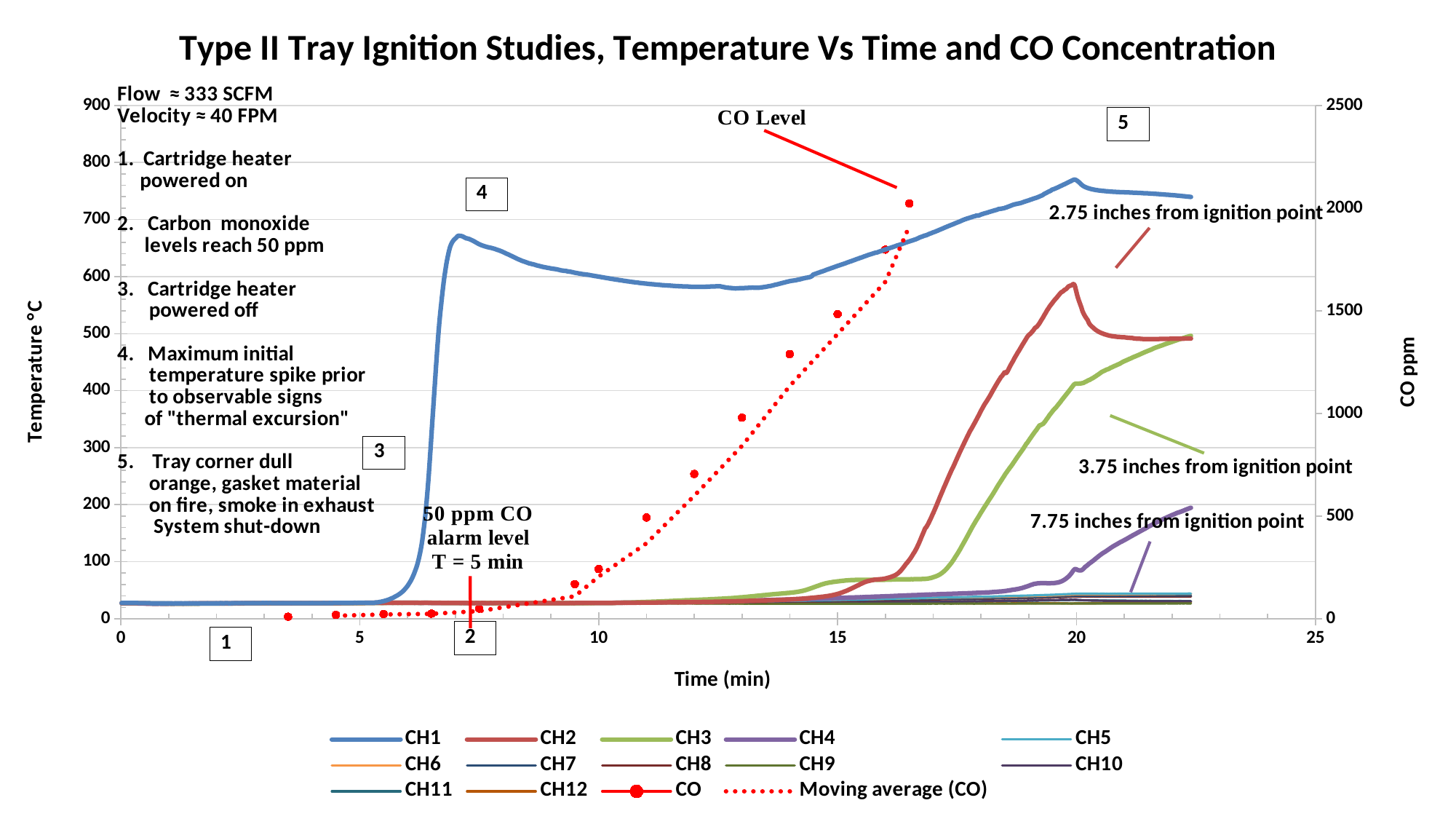
What is the title of the chart? Type II Tray Ignition Studies, Temperature Vs Time and CO Concentration Which series reaches the highest temperature on the chart? CH1 How many series does the legend list? 14 What kind of chart is shown on the slide? line chart Is the CO value at 15 minutes greater or less than 1000 ppm? greater Is the CO value at 12 minutes greater or less than 1000 ppm? less Does the CH1 temperature rise or fall between 10 and 20 minutes? rise What is the label of the x axis? Time (min) At 20 minutes, which series has the higher temperature, CH1 or CH2? CH1 Is the peak value of CH2 near 20 minutes greater or less than 500 °C? greater